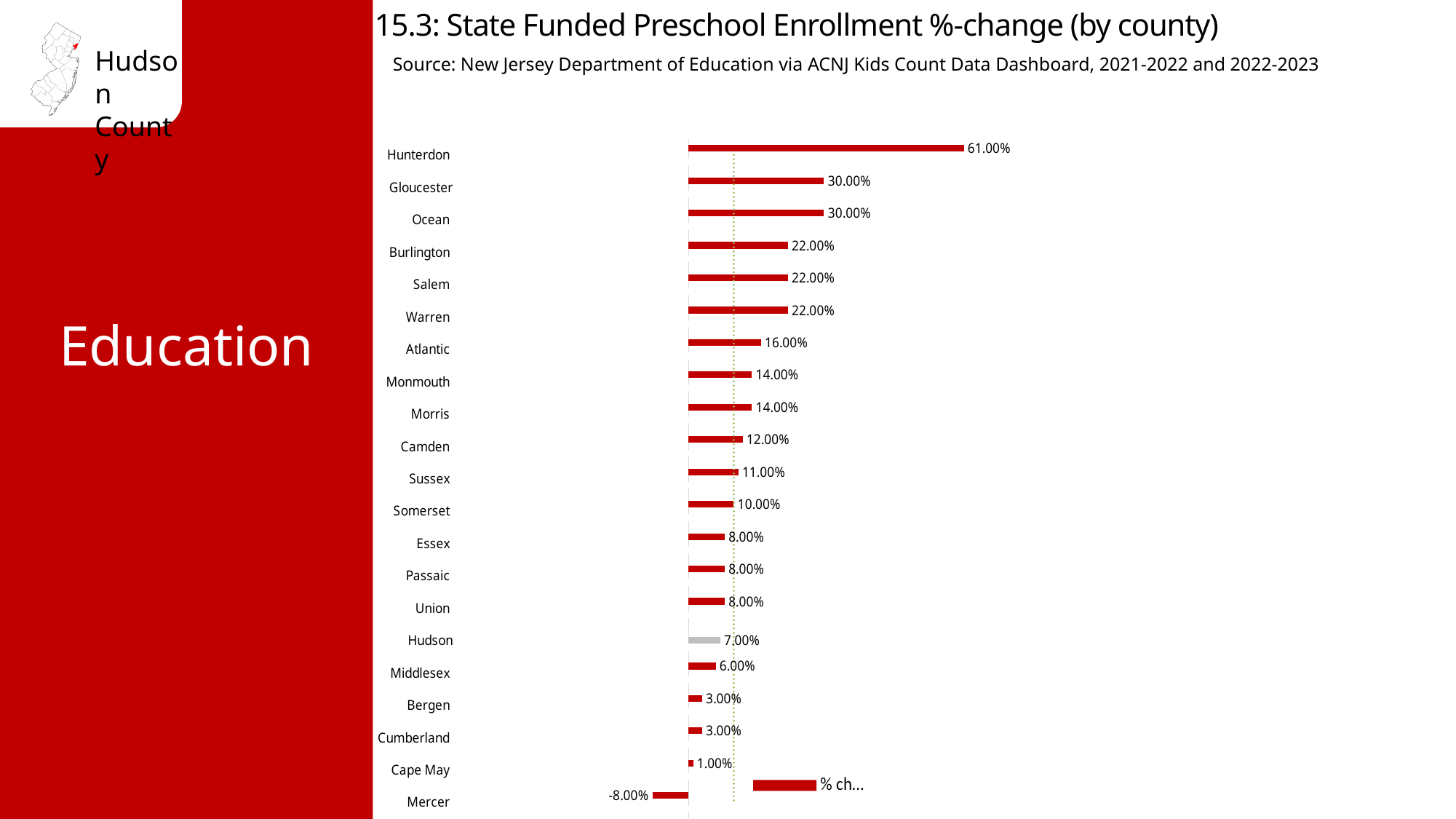
How many counties are shown in the chart? 21 What is the value shown for Hunterdon? 61.00% Which has a larger %-change, Atlantic or Camden? Atlantic What is the difference between the values for Hunterdon and Gloucester? 31.00% What is the value shown for Mercer? -8.00% Which county's bar is coloured grey instead of red? Hudson Which county has the highest %-change? Hunterdon What is the value shown for Cape May? 1.00% Which county has the lowest %-change? Mercer What is the state funded preschool enrollment %-change for Hudson County? 7.00% What kind of chart is shown on the slide? Bar chart What is the difference between the values for Hudson and Middlesex? 1.00%